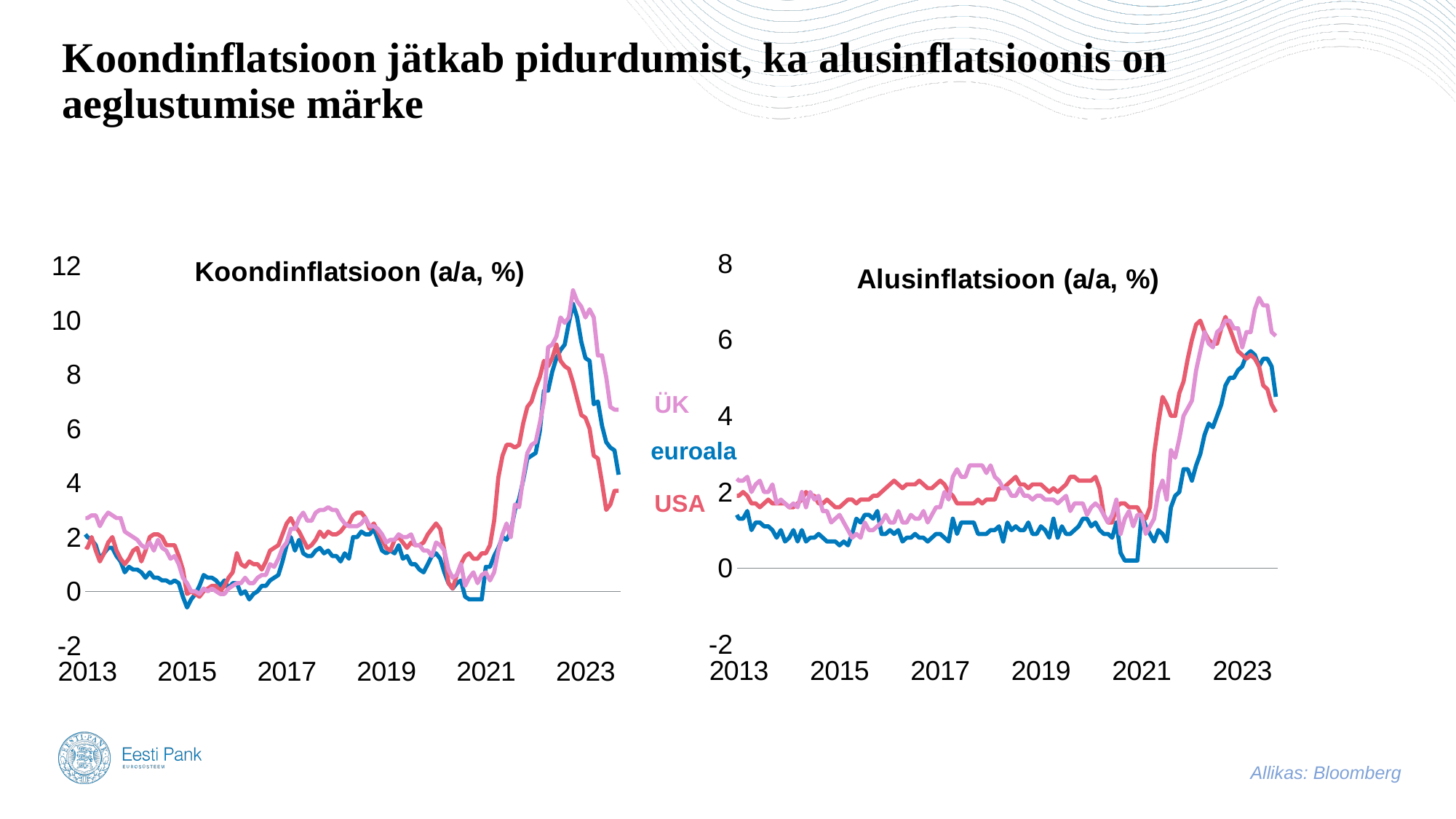
In the Alusinflatsioon (a/a, %) chart, is the euroala value at the start of 2021 greater or less than 2? less In the Koondinflatsioon (a/a, %) chart, which reached a higher peak, ÜK or USA? ÜK In the Koondinflatsioon (a/a, %) chart, which series has the lowest value around 2015, euroala or ÜK? euroala How many series are shown in the legend shared by the two charts? 3 In the Koondinflatsioon (a/a, %) chart, is the peak value of USA greater or less than 8? greater In the Alusinflatsioon (a/a, %) chart, is the peak value of euroala greater or less than 4? greater In the Koondinflatsioon (a/a, %) chart, do the values rise or fall from the 2022 peak to the end of the series? fall In the Alusinflatsioon (a/a, %) chart, which series reaches the highest peak? ÜK What type of chart is used for Koondinflatsioon (a/a, %)? line chart Which colour represents USA in the charts? red What is the title of the chart on the right? Alusinflatsioon (a/a, %)